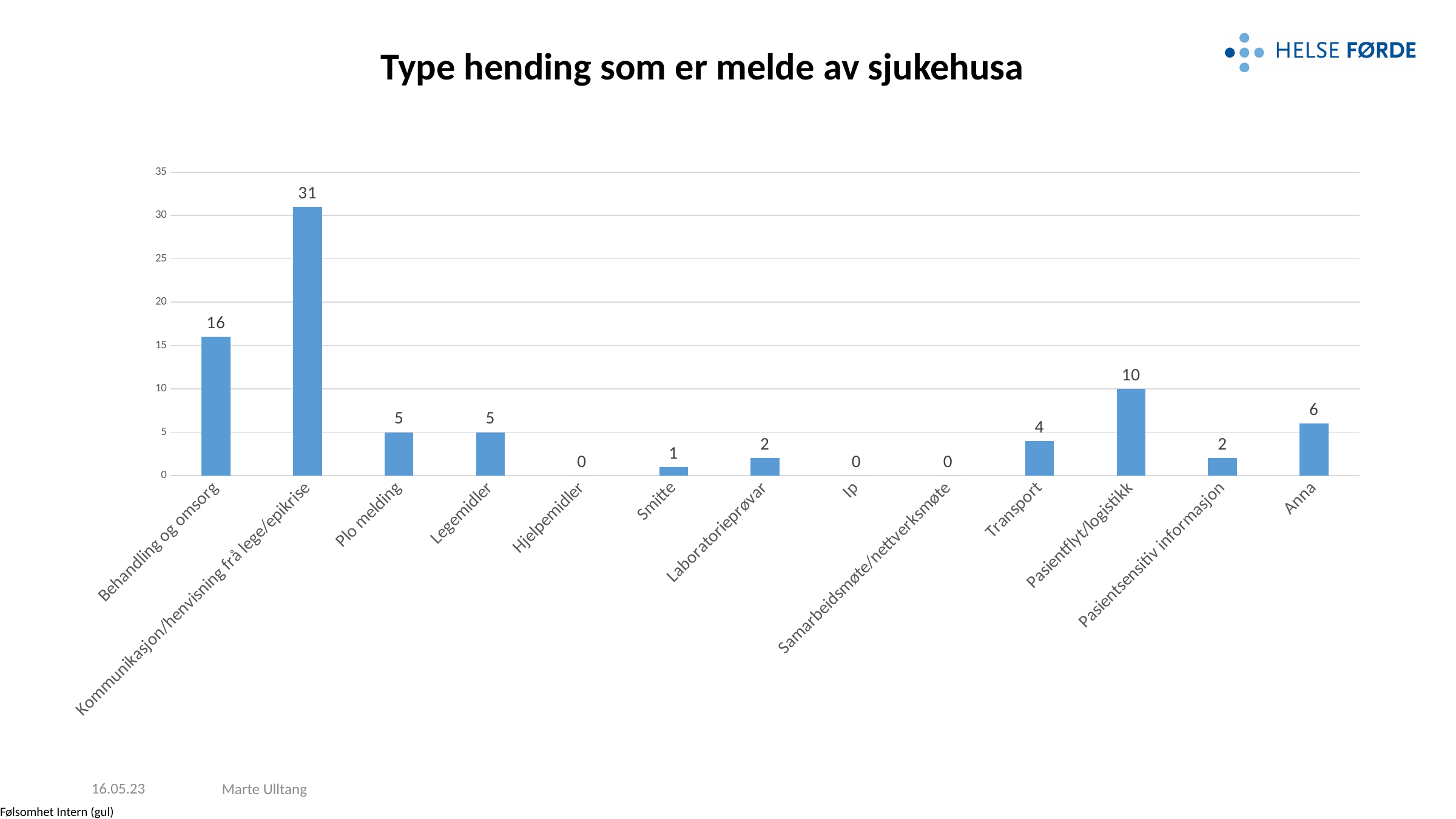
What is the value for Kommunikasjon/henvisning frå lege/epikrise? 31 Which is larger, the value for Anna or the value for Plo melding? Anna What is the value for Transport? 4 How many categories are shown on the x axis? 13 What is the difference between the values for Kommunikasjon/henvisning frå lege/epikrise and Behandling og omsorg? 15 Which category has the highest value? Kommunikasjon/henvisning frå lege/epikrise What kind of chart is shown on the slide? bar chart What is the title of the chart? Type hending som er melde av sjukehusa What is the value for Behandling og omsorg? 16 How many categories have a value of 0? 3 Is the value for Behandling og omsorg greater or less than 15? greater What is the value for Pasientflyt/logistikk? 10